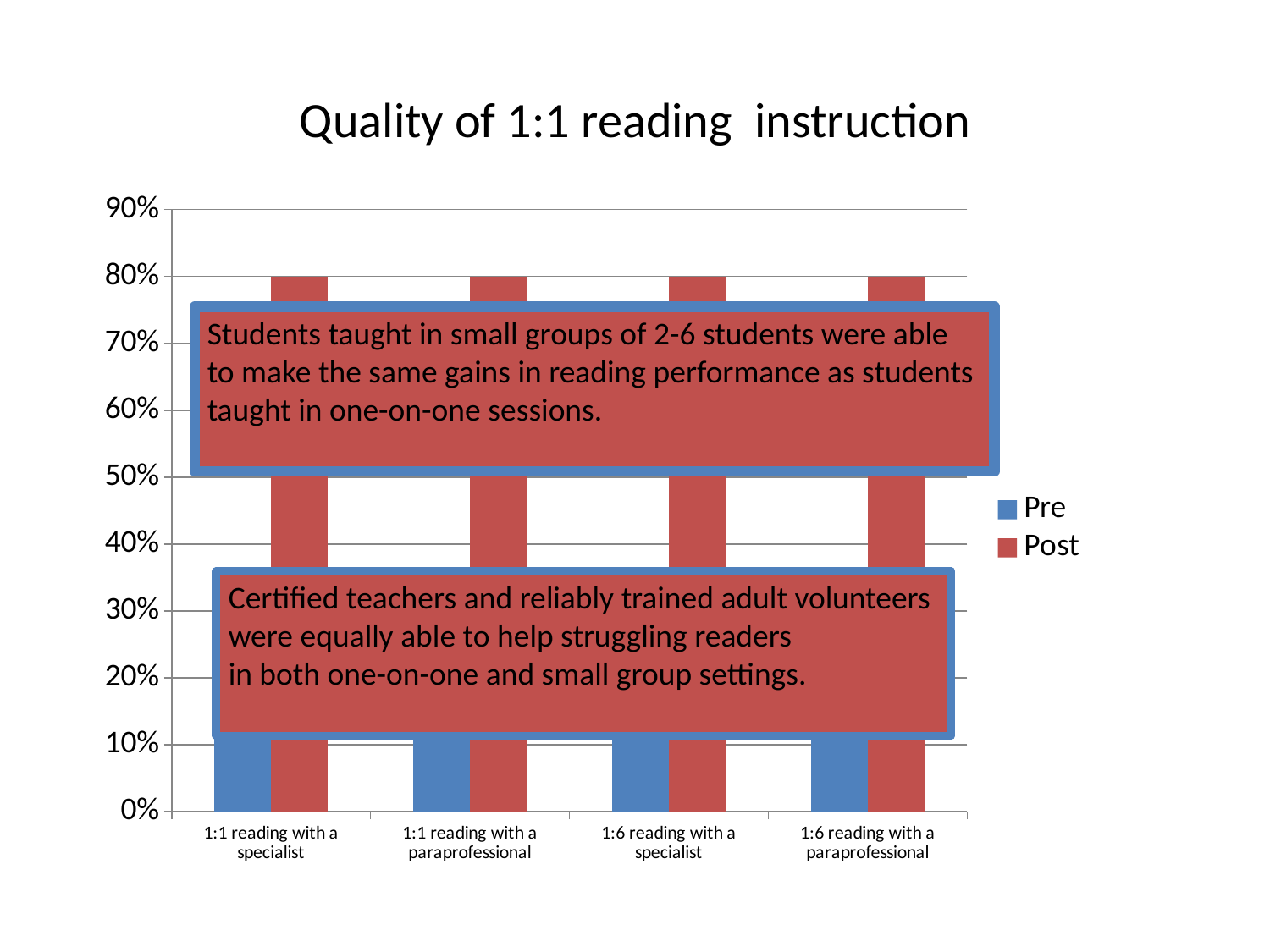
Is the Pre value for 1:6 reading with a specialist greater or less than 50%? less Which series is shown in red? Post How many series does the legend list? 2 What is the Post value for 1:1 reading with a specialist? 80% What kind of chart is shown on the slide? bar chart For 1:1 reading with a paraprofessional, which is larger, the Pre value or the Post value? Post Is the Pre value for 1:1 reading with a specialist greater or less than 10%? greater Is the Post value for 1:6 reading with a specialist greater or less than 70%? greater What is the Post value for 1:1 reading with a paraprofessional? 80% What is the title of the chart? Quality of 1:1 reading instruction What is the Post value for 1:6 reading with a paraprofessional? 80% How many categories are shown on the x axis? 4